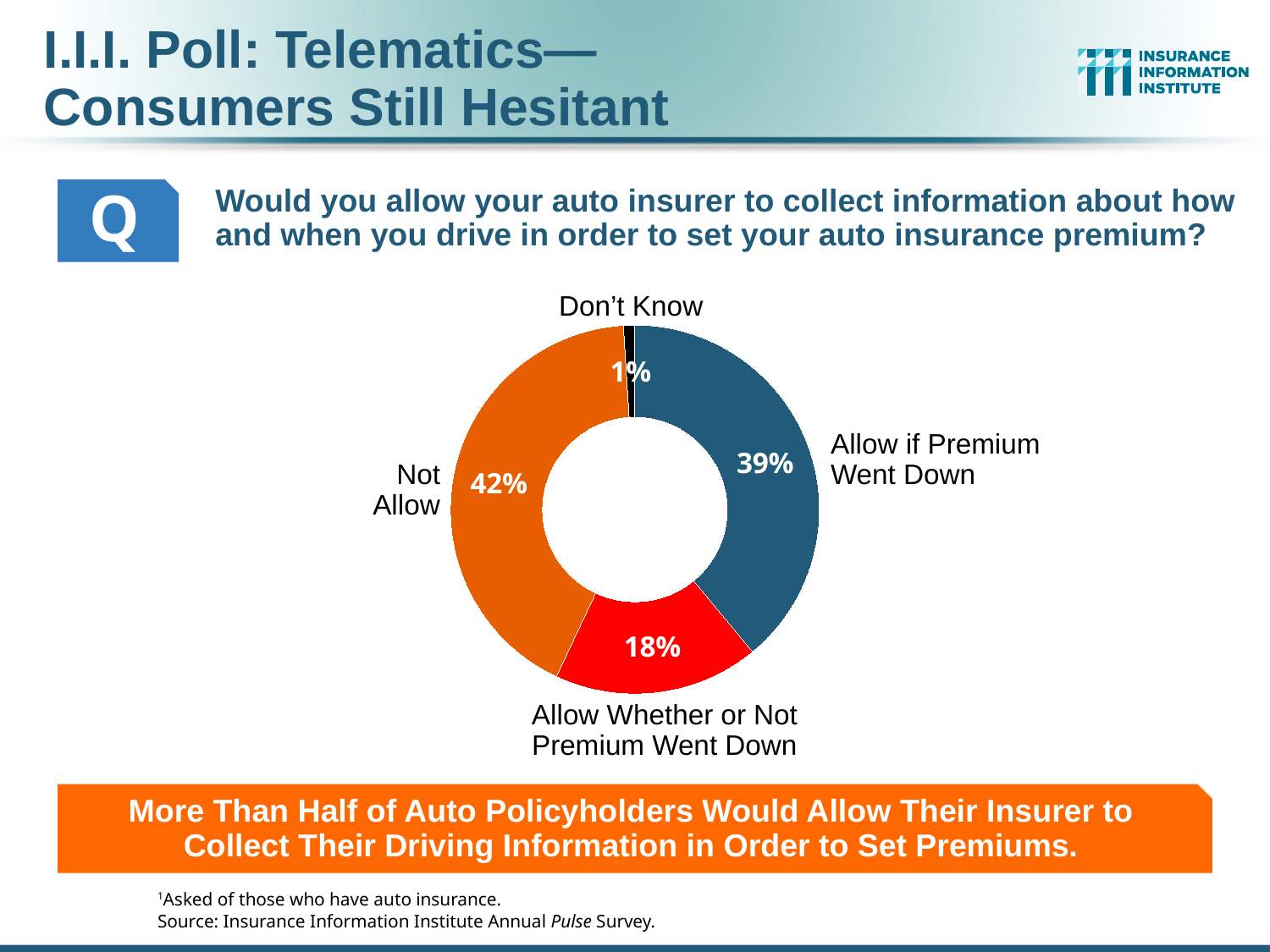
Which is larger: 'Allow if Premium Went Down' or 'Allow Whether or Not Premium Went Down'? Allow if Premium Went Down What kind of chart is shown on the slide? Doughnut (pie) chart What colour is the 'Not Allow' segment of the chart? Orange Which response has the largest share of the chart? Not Allow What percentage of respondents would allow their insurer to collect driving information if their premium went down? 39% What percentage of respondents would allow data collection whether or not their premium went down? 18% What percentage of respondents would not allow their insurer to collect driving information? 42% What is the difference in percentage points between 'Not Allow' and 'Allow if Premium Went Down'? 3 What is the combined percentage of respondents who would allow data collection (either if premium went down or whether or not it went down)? 57% What percentage of respondents answered 'Don't Know'? 1% How many response categories are shown in the chart? 4 Which response has the smallest share of the chart? Don't Know